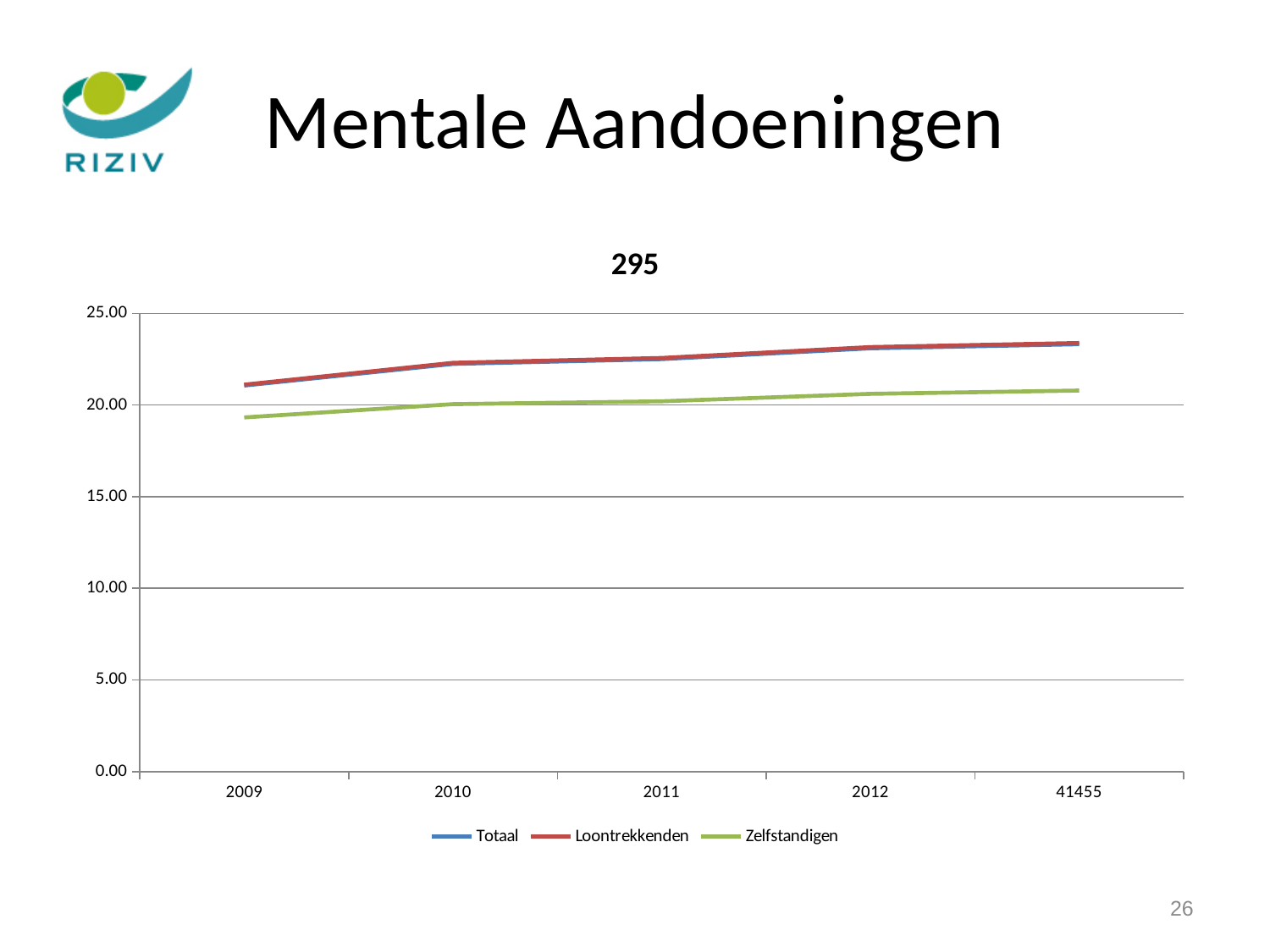
Which series are listed in the legend? Totaal, Loontrekkenden, Zelfstandigen Which is larger in 2011, the value for Loontrekkenden or the value for Zelfstandigen? Loontrekkenden What is the title of the chart? 295 How many points are plotted along the x axis for each series? 5 Do the values for Zelfstandigen rise or fall from 2009 to the last point on the x axis? rise Do the values for Loontrekkenden rise or fall from 2009 to 2012? rise Is the value for Loontrekkenden in 2009 greater or less than 20.00? greater Is the value for Zelfstandigen in 2009 greater or less than 20.00? less Which series has the lowest values across all years? Zelfstandigen How many series does the legend list? 3 Is the value for Zelfstandigen in 2012 greater or less than 20.00? greater What kind of chart is shown on the slide? line chart